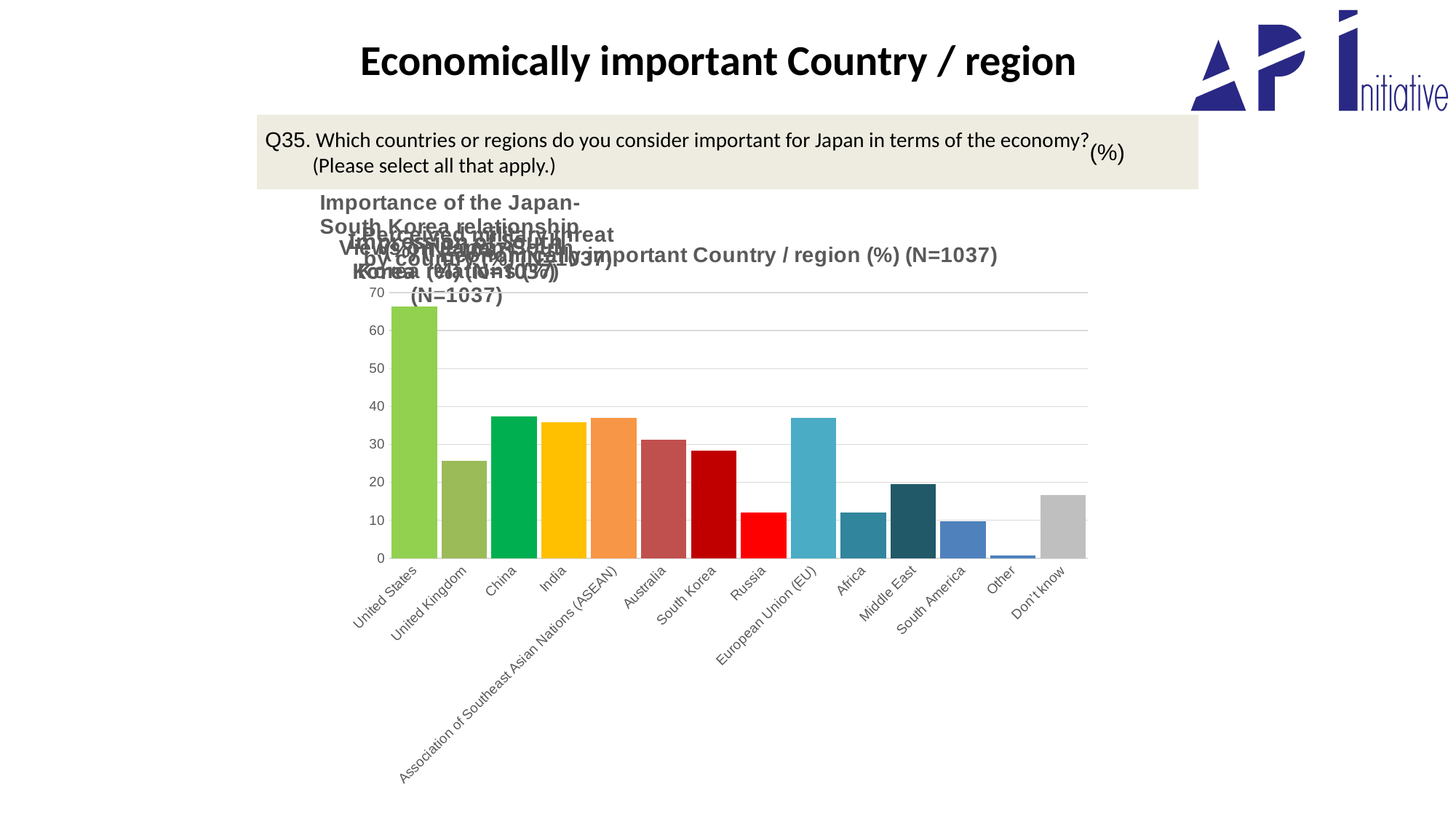
Is the value for Don't know greater or less than 20? less Is the value for South America greater or less than 20? less Is the value for Russia greater or less than 20? less Which has a larger value, Middle East or South America? Middle East How many countries or regions are plotted on the chart? 14 What kind of chart is shown on the slide? bar chart Which country or region has the highest value on the chart? United States Which category has the lowest value on the chart? Other Which has a larger value, United States or United Kingdom? United States What sample size (N) is stated in the chart title? N=1037